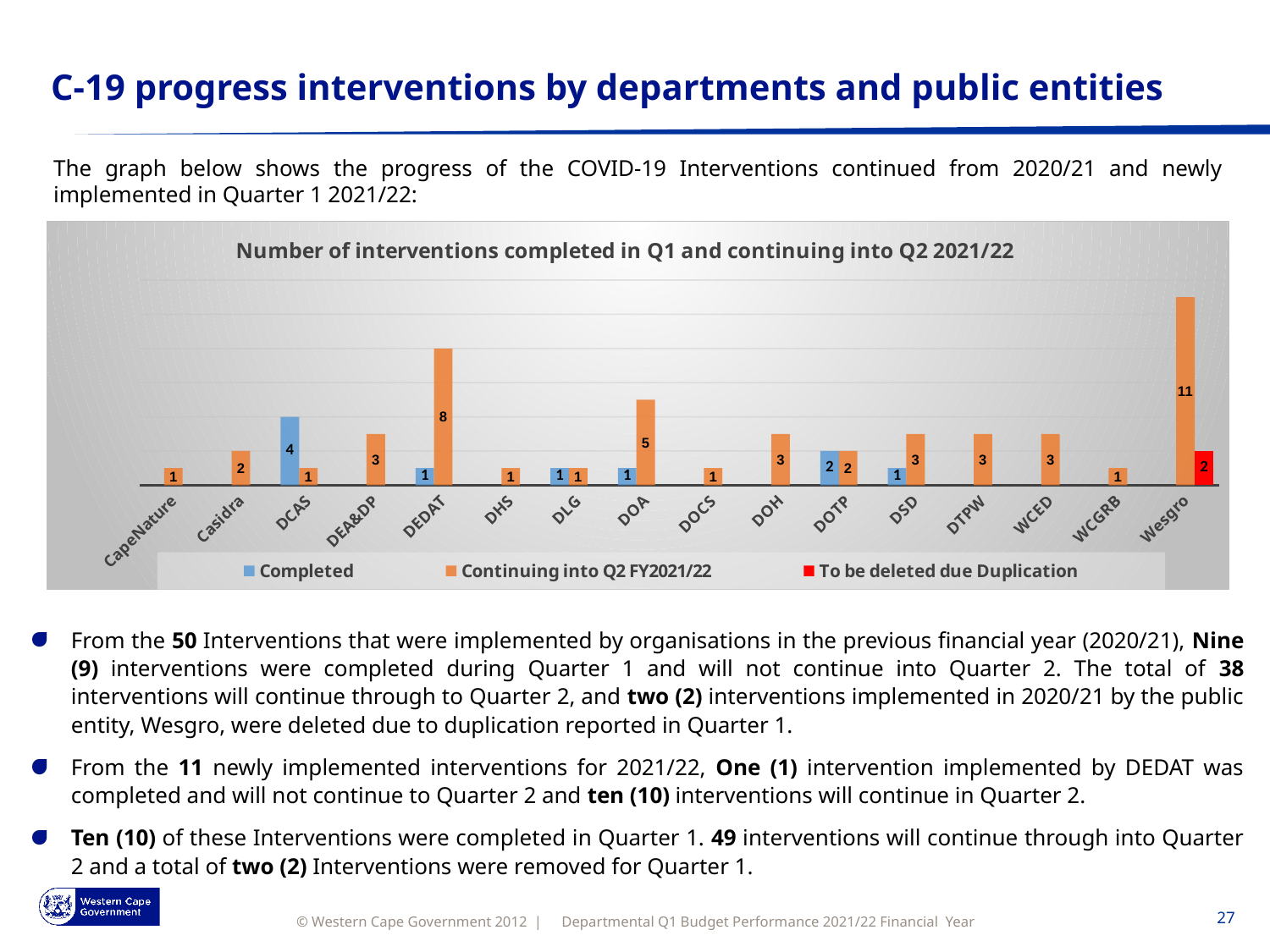
What is the 'Completed' value for DCAS? 4 How many departments or public entities are shown on the x axis? 16 What is the value for Wesgro in the 'To be deleted due Duplication' series? 2 What is the difference between the 'Continuing into Q2 FY2021/22' values for Wesgro and DEDAT? 3 Which entity has the highest value in the 'Continuing into Q2 FY2021/22' series? Wesgro How many series does the legend list? 3 What is the value for Wesgro in the 'Continuing into Q2 FY2021/22' series? 11 What type of chart is shown on the slide? Bar chart What is the title of the chart? Number of interventions completed in Q1 and continuing into Q2 2021/22 Which entity has the highest 'Completed' value? DCAS Which is larger: the 'Continuing into Q2 FY2021/22' value for DOA or for DOH? DOA What is the value for DEDAT in the 'Continuing into Q2 FY2021/22' series? 8